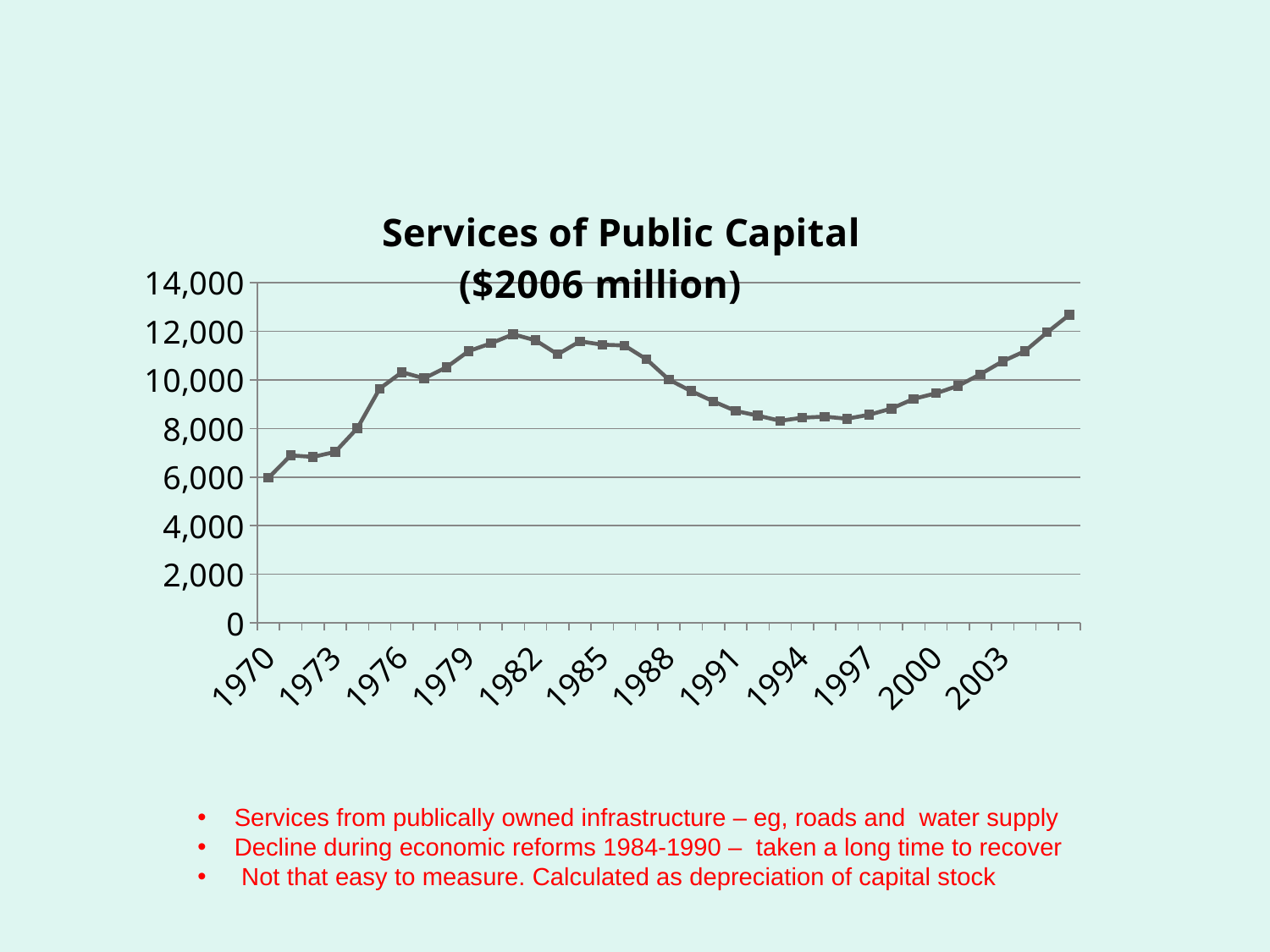
Is the value for 1970 greater or less than 8,000? less Is the value for 1976 greater or less than 8,000? greater Is the value for 1982 greater or less than 10,000? greater Do the values rise or fall between 1985 and 1994? fall What kind of chart is shown on the slide? line chart Which is larger, the value for 1982 or the value for 1994? 1982 Which year has the lowest value on the chart? 1970 Do the values rise or fall between 1970 and 1976? rise What is the title of the chart? Services of Public Capital ($2006 million) Which is larger, the value for 1970 or the value for 1976? 1976